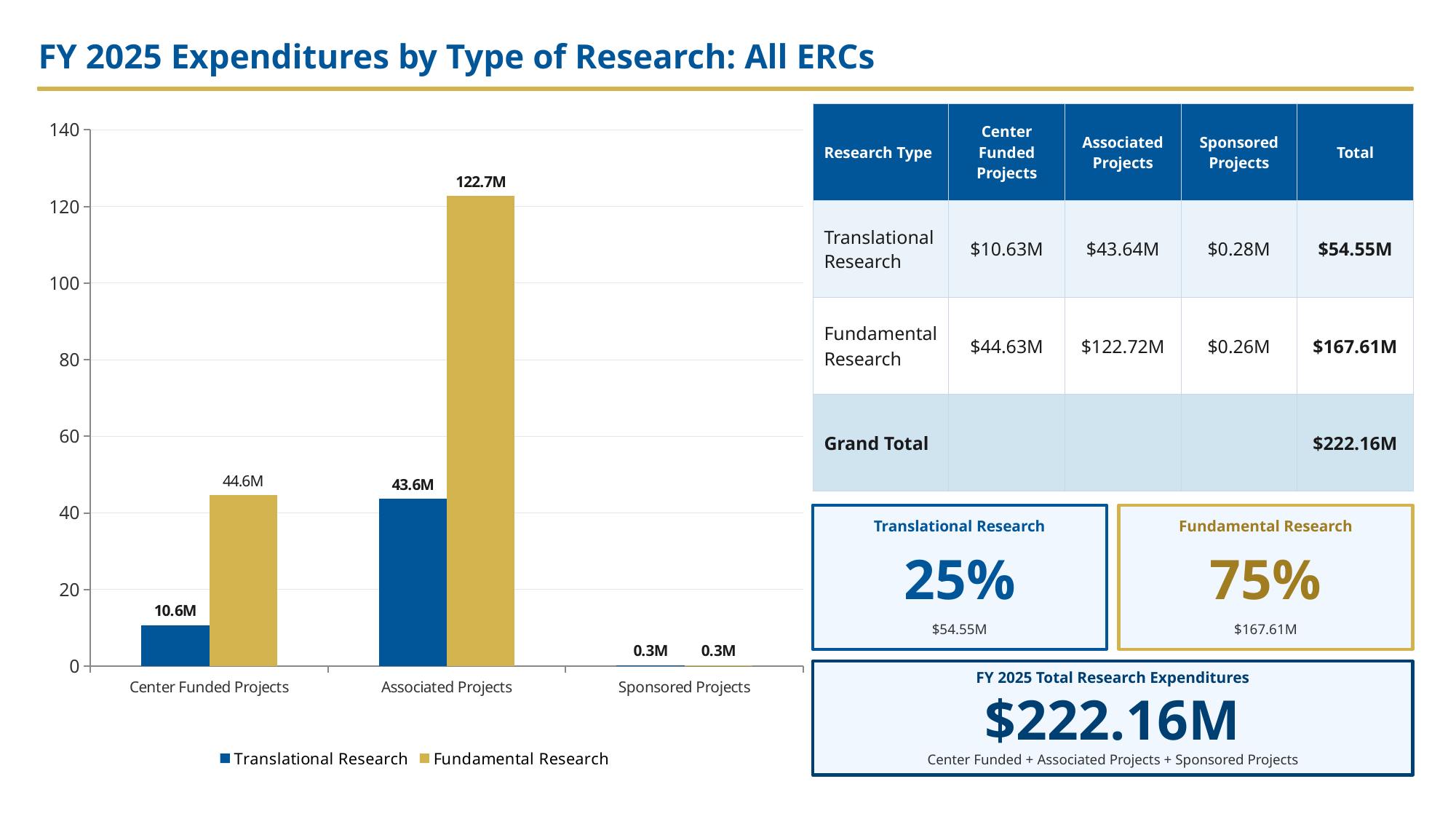
What type of chart is shown on the slide? bar chart What is the difference between the Fundamental Research and Translational Research values for Associated Projects in the chart? 79.1M How many project categories are shown on the x axis of the chart? 3 What is the Fundamental Research value for Associated Projects in the chart? 122.7M Is the Fundamental Research value for Associated Projects greater or less than 100? greater Which category has the lowest Translational Research value in the chart? Sponsored Projects How many series does the chart legend list? 2 What is the Translational Research value for Center Funded Projects in the chart? 10.6M What is the Translational Research value for Associated Projects in the chart? 43.6M Which category has the highest Fundamental Research value in the chart? Associated Projects Which is larger in the chart: the Fundamental Research value for Center Funded Projects or the Translational Research value for Associated Projects? Fundamental Research value for Center Funded Projects What is the Fundamental Research value for Center Funded Projects in the chart? 44.6M